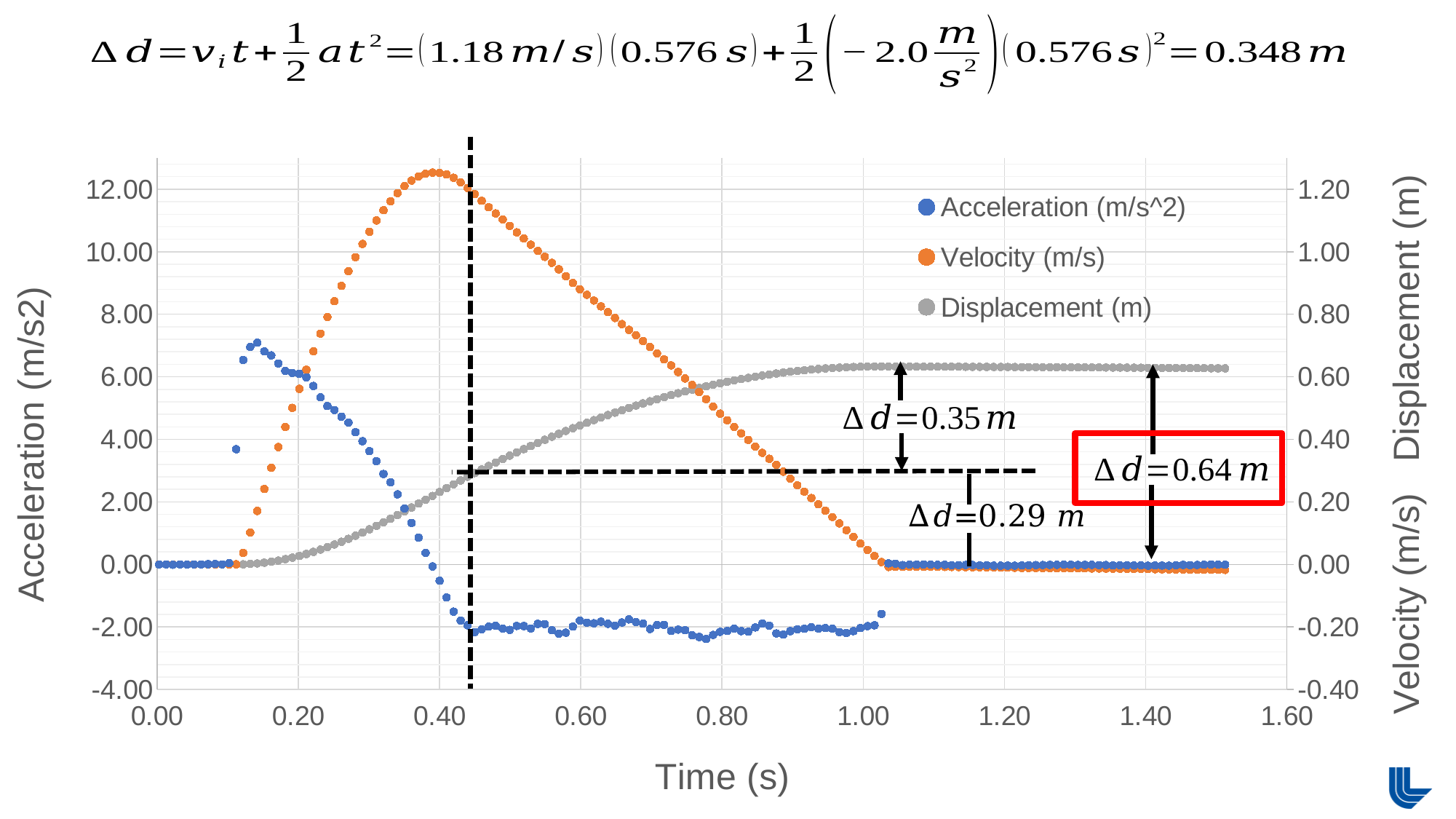
What is the title of the x axis of the chart? Time (s) Is the value of the Acceleration (m/s^2) series at 0.60 s greater or less than 0.00? less Does the Velocity (m/s) series rise or fall between 0.60 s and 1.00 s? fall Is the value of the Velocity (m/s) series at 1.20 s greater or less than 0.20 on the right axis? less Is the final plateau value of the Displacement (m) series greater or less than 0.40 on the right axis? greater What kind of chart is shown on the slide? scatter chart How many series does the legend list? 3 Does the Displacement (m) series rise or fall between 0.40 s and 0.80 s? rise Which series are listed in the chart legend? Acceleration (m/s^2), Velocity (m/s), Displacement (m) Does the Velocity (m/s) series rise or fall between 0.20 s and 0.40 s? rise